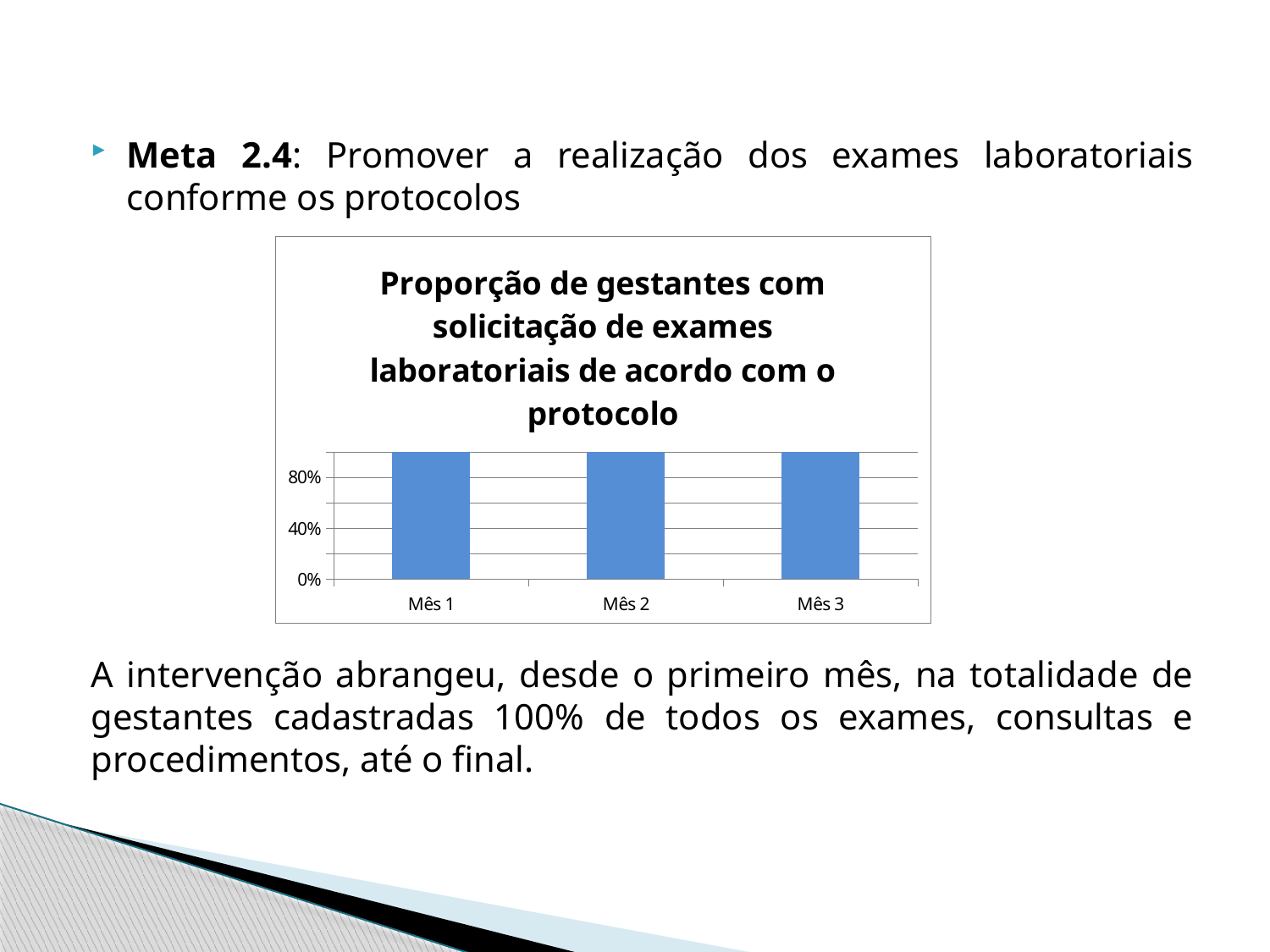
How many categories are shown on the x axis of the chart? 3 Is the value for Mês 3 greater or less than 40%? greater What is the label of the first category on the x axis? Mês 1 Is the value for Mês 2 greater or less than 80%? greater Do the values rise, fall or stay the same from Mês 1 to Mês 3? stay the same What is the title of the chart? Proporção de gestantes com solicitação de exames laboratoriais de acordo com o protocolo What kind of chart is shown on the slide? bar chart Is the value for Mês 1 greater or less than 80%? greater What is the highest value labelled on the y axis of the chart? 80%